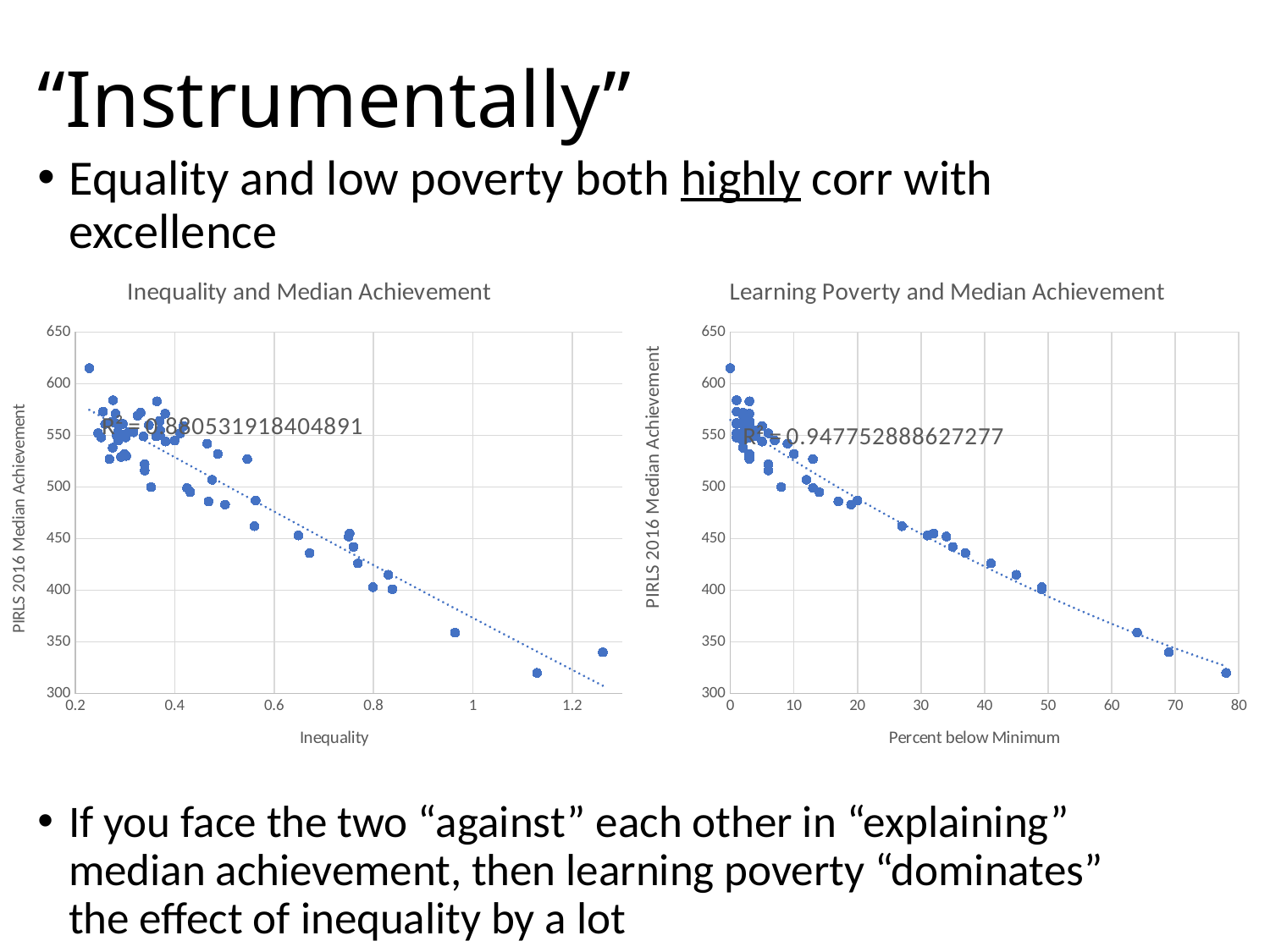
In the 'Inequality and Median Achievement' chart, do the values rise or fall as inequality increases along the x axis? fall What kind of chart is the 'Learning Poverty and Median Achievement' chart? scatter chart What is the y-axis title of the 'Inequality and Median Achievement' chart? PIRLS 2016 Median Achievement In the 'Learning Poverty and Median Achievement' chart, is the value for the point at 0 percent below minimum greater or less than 600? greater In the 'Inequality and Median Achievement' chart, is the value for the point at the lowest inequality (about 0.23) greater or less than 600? greater In the 'Inequality and Median Achievement' chart, is the value for the point at the highest inequality (about 1.26) greater or less than 400? less In the 'Learning Poverty and Median Achievement' chart, do the values rise or fall as percent below minimum increases along the x axis? fall What R² value is printed on the 'Learning Poverty and Median Achievement' chart? 0.947752888627277 What is the x-axis title of the 'Learning Poverty and Median Achievement' chart? Percent below Minimum What kind of chart is the 'Inequality and Median Achievement' chart? scatter chart